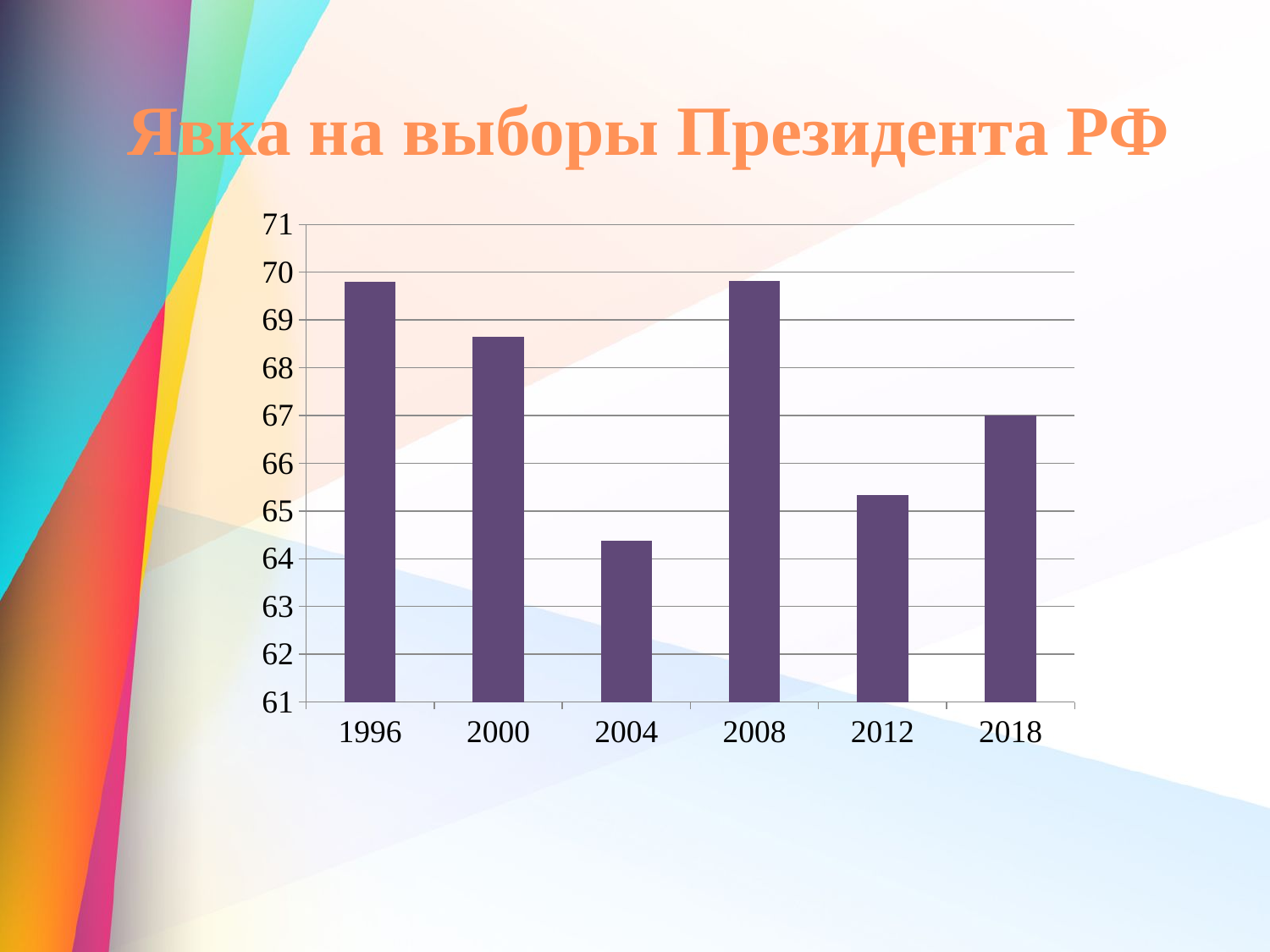
Is the value for 2004 greater or less than 65? less Is the value for 1996 greater or less than 69? greater Is the value for 2000 greater or less than 68? greater What kind of chart is shown on the slide? bar chart What is the title of the slide? Явка на выборы Президента РФ Which is larger, the value for 2018 or the value for 2004? 2018 Which year has the lowest turnout in the chart? 2004 Which is larger, the value for 2000 or the value for 2012? 2000 How many years are shown on the x axis of the chart? 6 Do the values rise or fall from 2008 to 2012? fall